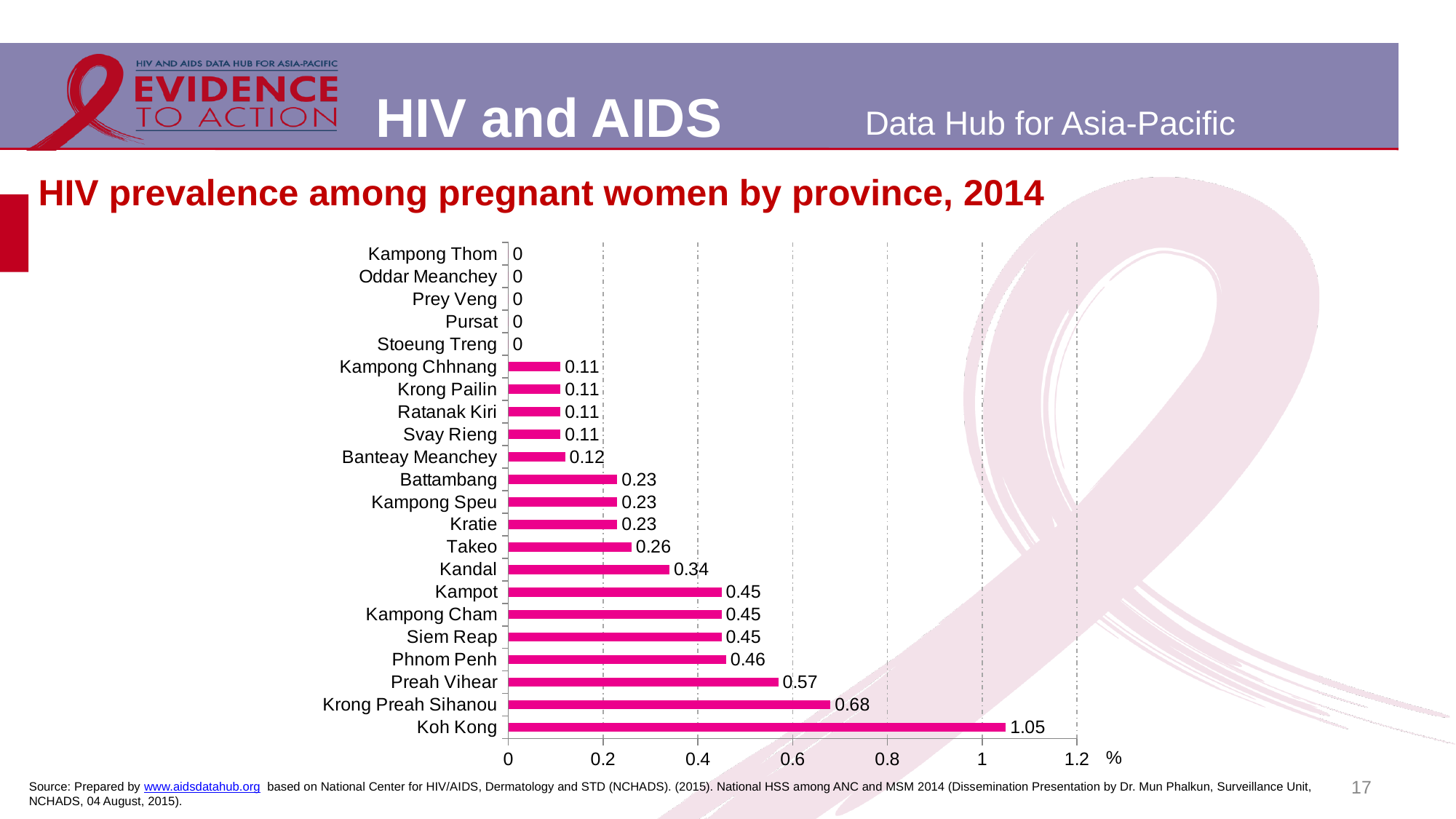
What is the difference in HIV prevalence between Preah Vihear and Takeo? 0.31 How many provinces are shown in the chart? 22 How many provinces have an HIV prevalence of 0? 5 Which has a higher HIV prevalence, Kampot or Banteay Meanchey? Kampot What is the HIV prevalence among pregnant women in Phnom Penh? 0.46 What is the HIV prevalence among pregnant women in Kandal? 0.34 What is the title of the chart? HIV prevalence among pregnant women by province, 2014 Which province has the highest HIV prevalence among pregnant women? Koh Kong What type of chart is used on the slide? Bar chart What is the HIV prevalence among pregnant women in Koh Kong? 1.05 What is the difference in HIV prevalence between Koh Kong and Krong Preah Sihanou? 0.37 Is the value for Krong Preah Sihanou greater or less than 0.6? greater